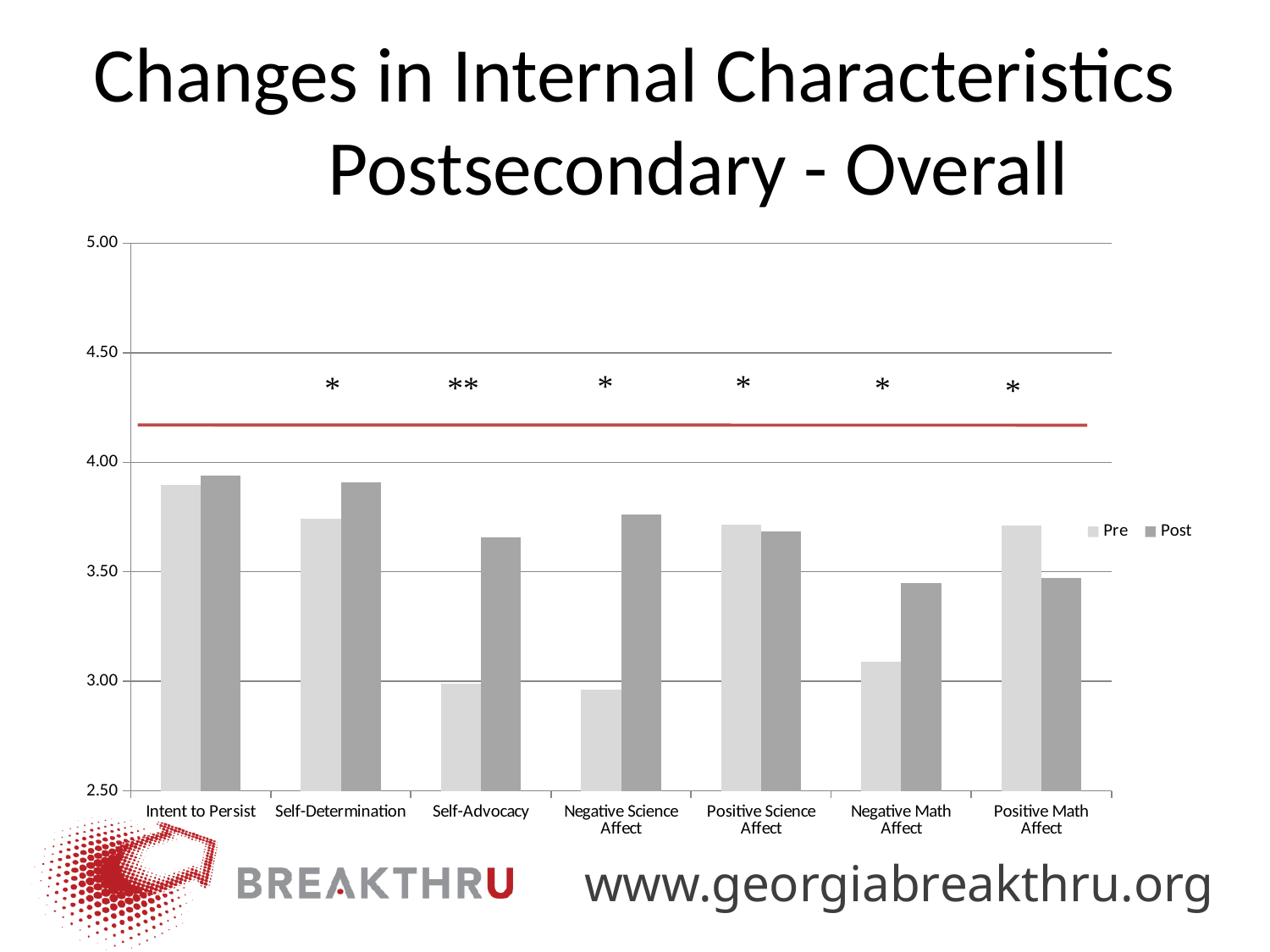
What kind of chart is shown on the slide? bar chart How many categories are shown along the x axis of the chart? 7 Is the Post value for Intent to Persist greater or less than 4.00? less Is the Pre value for Negative Science Affect greater or less than 3.00? less Is the Post value for Negative Science Affect greater or less than 3.50? greater For Negative Math Affect, which is larger, the Pre value or the Post value? Post Which category has the highest Pre value? Intent to Persist For Self-Advocacy, which is larger, the Pre value or the Post value? Post What are the two series named in the chart's legend? Pre and Post How many series does the chart's legend list? 2 For Positive Math Affect, which is larger, the Pre value or the Post value? Pre